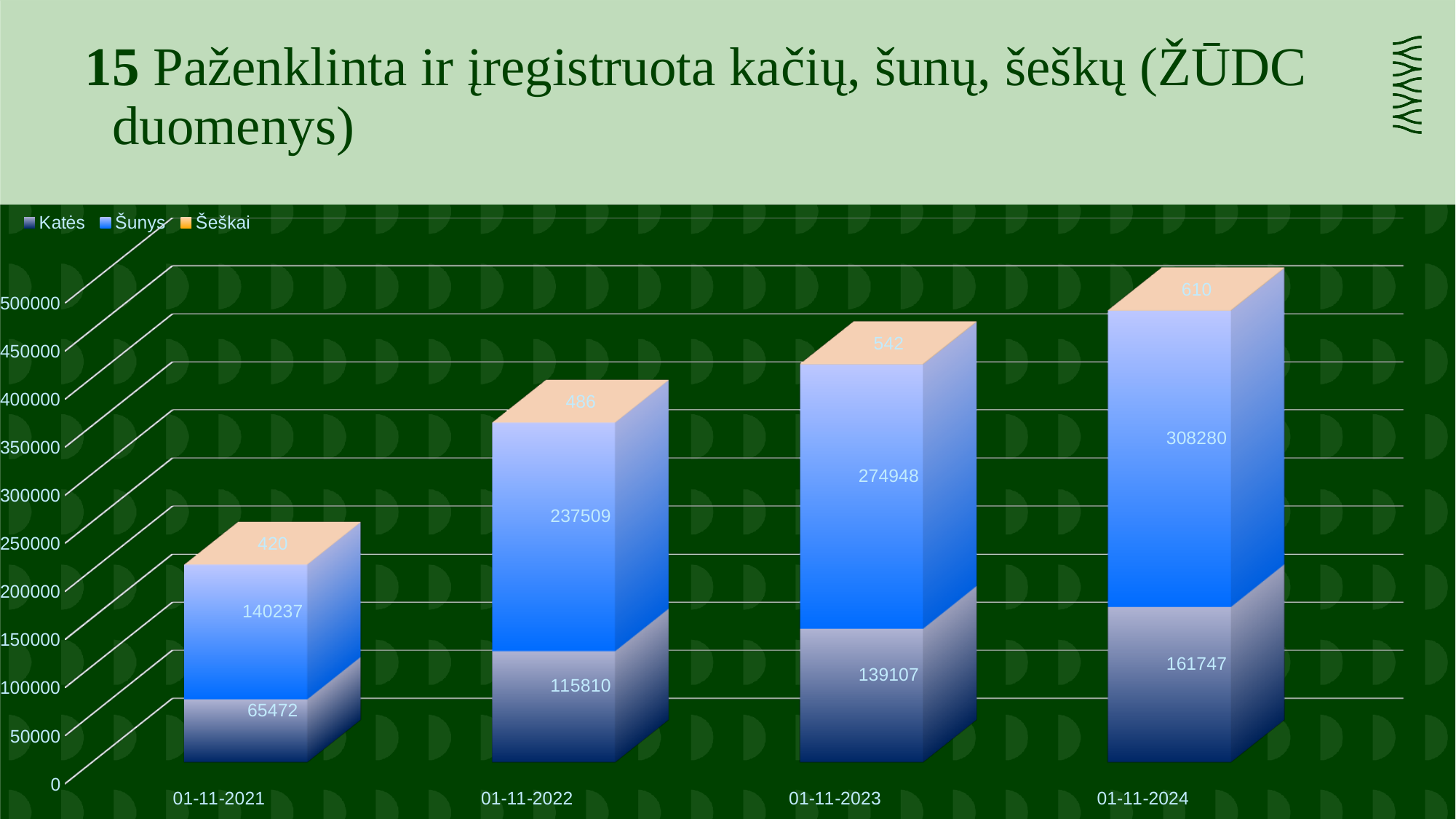
Do the Katės values rise or fall from 01-11-2021 to 01-11-2024? rise What is the difference between the Šunys values on 01-11-2024 and 01-11-2021? 168043 What is the value for Katės on 01-11-2021? 65472 On which date is the value for Šunys highest? 01-11-2024 Which is larger: Katės on 01-11-2022 or Katės on 01-11-2023? Katės on 01-11-2023 What is the total of the stacked bar for 01-11-2021? 206129 What type of chart is shown on the slide? stacked bar chart What is the value for Šeškai on 01-11-2024? 610 On which date is the value for Katės lowest? 01-11-2021 How many dates are shown on the x axis? 4 What is the value for Šunys on 01-11-2023? 274948 How many series does the legend list? 3